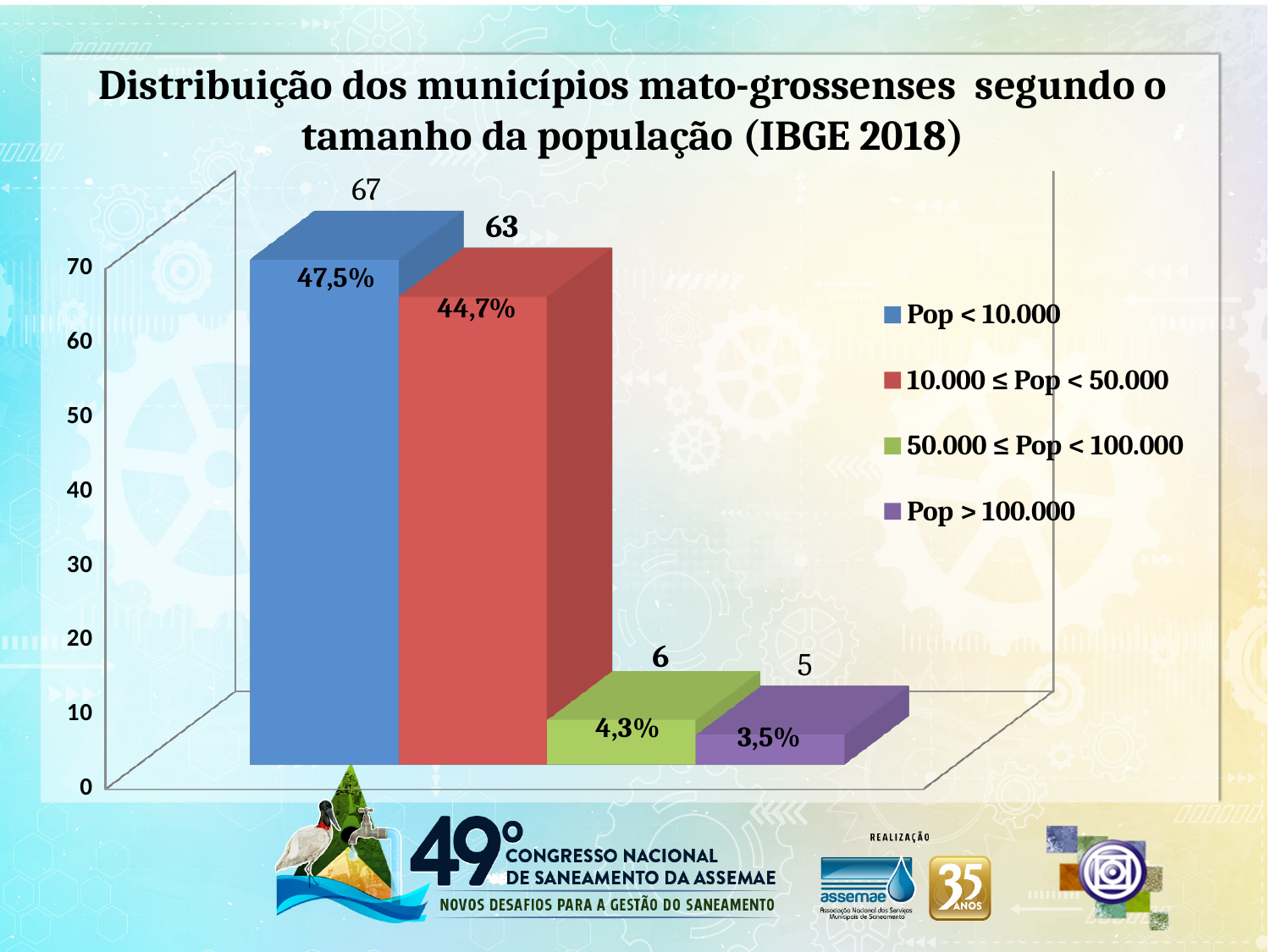
What is the difference in the number of municipalities between 'Pop < 10.000' and '10.000 ≤ Pop < 50.000'? 4 Which category has the highest number of municipalities? Pop < 10.000 How many population categories are plotted in the chart? 4 How many municipalities are in the '10.000 ≤ Pop < 50.000' category? 63 What percentage share is shown for the '50.000 ≤ Pop < 100.000' category? 4,3% Which has more municipalities: '50.000 ≤ Pop < 100.000' or 'Pop > 100.000'? 50.000 ≤ Pop < 100.000 What percentage share is shown for the 'Pop > 100.000' category? 3,5% How many municipalities are in the 'Pop < 10.000' category? 67 Is the value for '10.000 ≤ Pop < 50.000' greater or less than 50? greater What kind of chart is shown on the slide? bar chart What is the title of the chart? Distribuição dos municípios mato-grossenses segundo o tamanho da população (IBGE 2018) Which category has the lowest number of municipalities? Pop > 100.000